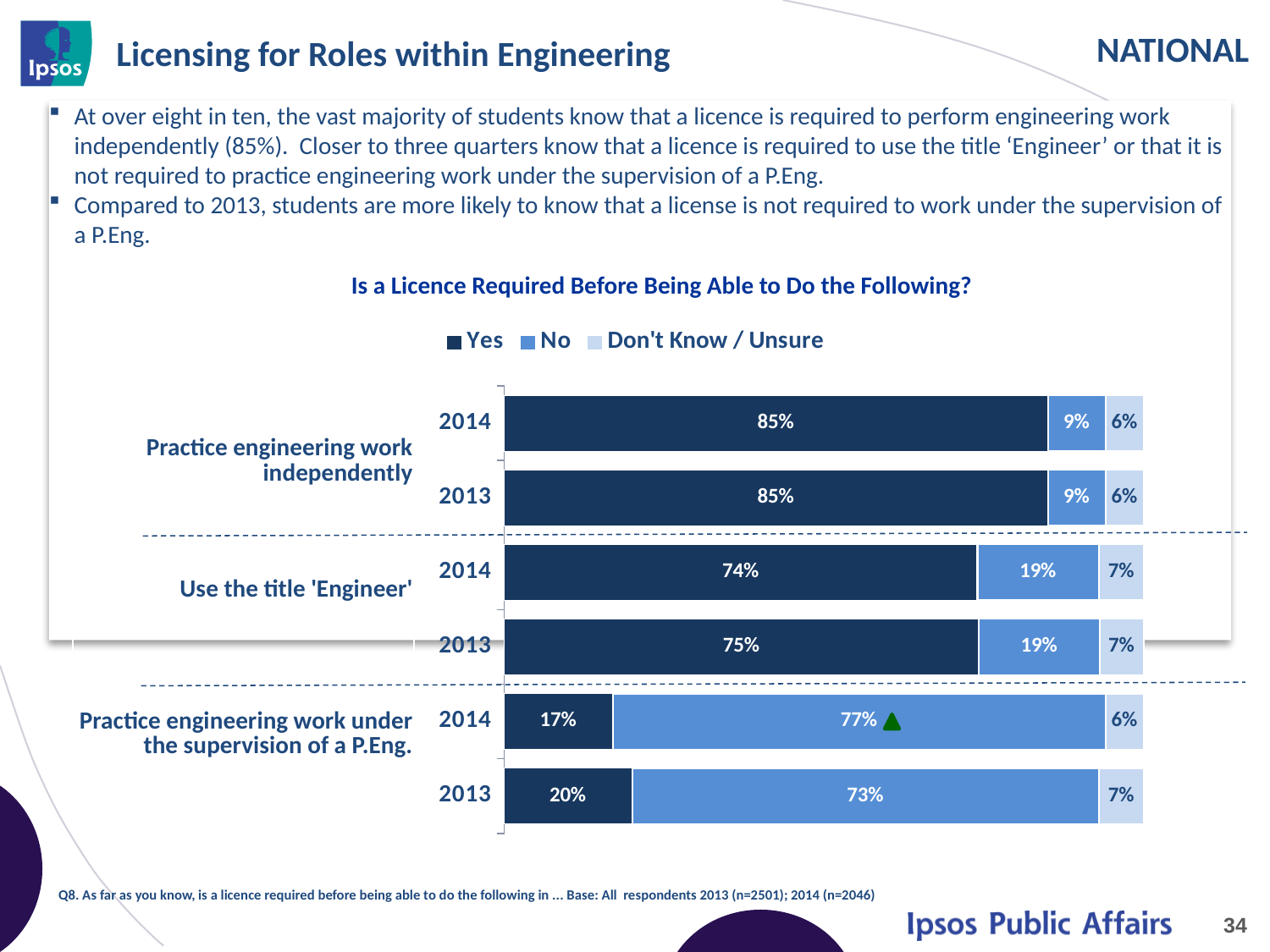
What is the difference between the 'Yes' percentages for 'Practice engineering work under the supervision of a P.Eng.' in 2013 and 2014? 3% Which bar has the lowest 'Yes' percentage in the chart? Practice engineering work under the supervision of a P.Eng., 2014 How many bars are shown in the chart? 6 What percentage of students in 2013 said 'No' for 'Use the title 'Engineer''? 19% What percentage of students in 2014 said 'Yes', a licence is required to practice engineering work independently? 85% How many series does the legend list? 3 What percentage of students in 2014 said 'No' for 'Practice engineering work under the supervision of a P.Eng.'? 77% What type of chart is shown on the slide? Stacked bar chart What percentage of students in 2013 answered 'Don't Know / Unsure' for 'Practice engineering work under the supervision of a P.Eng.'? 7% What is the difference between the 'No' percentages for 'Practice engineering work under the supervision of a P.Eng.' in 2014 and 2013? 4% Which year had the higher 'Yes' percentage for 'Use the title 'Engineer'', 2013 or 2014? 2013 What is the title of the chart? Is a Licence Required Before Being Able to Do the Following?